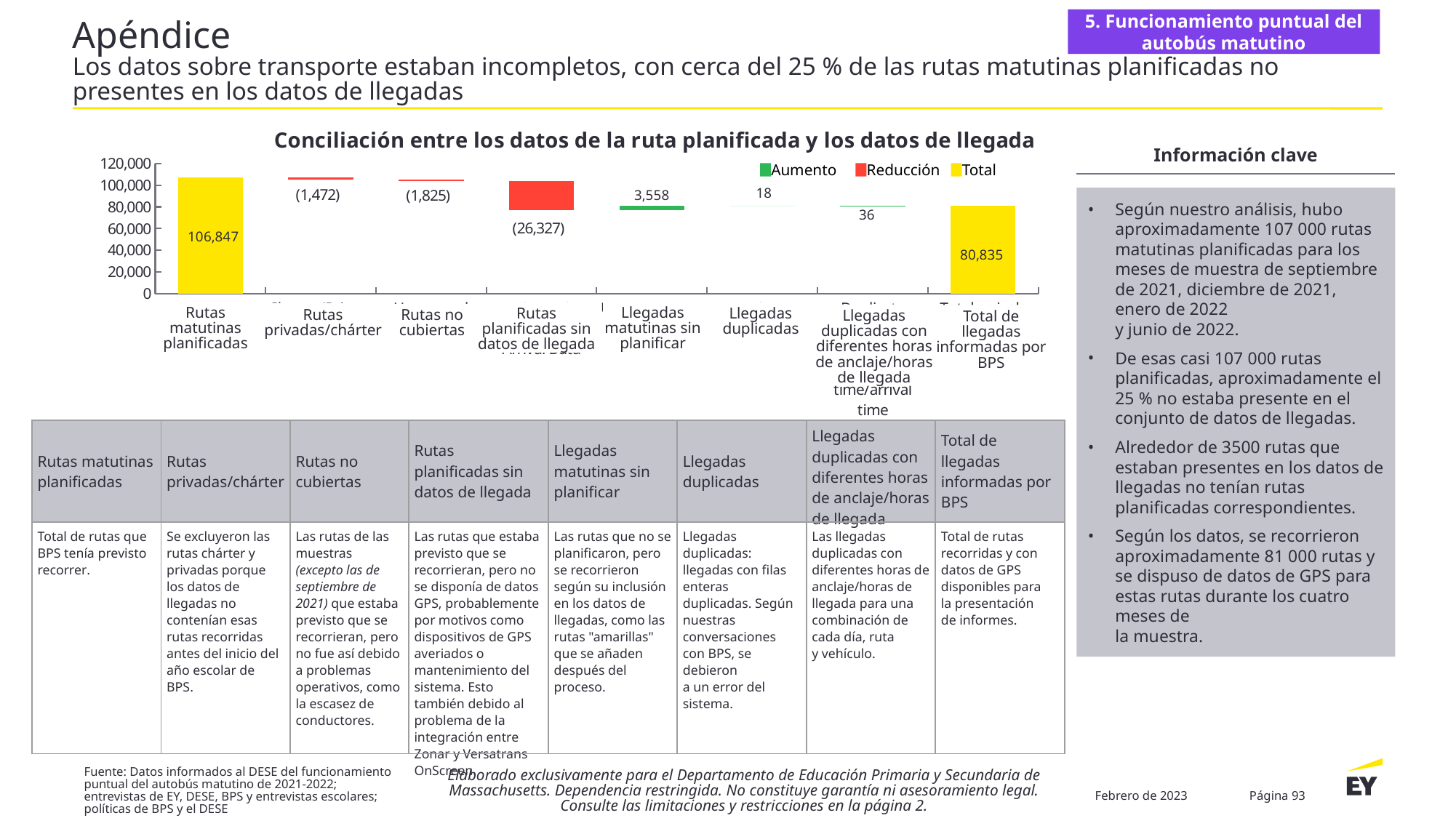
Which colour represents 'Reducción' in the legend? Red What value is shown for 'Rutas no cubiertas'? (1,825) How many categories are shown on the x axis? 8 What value is shown for 'Rutas planificadas sin datos de llegada'? (26,327) What value is shown for 'Rutas matutinas planificadas'? 106,847 What is the title of the chart? Conciliación entre los datos de la ruta planificada y los datos de llegada What value is shown for 'Rutas privadas/chárter'? (1,472) What value is shown for 'Total de llegadas informadas por BPS'? 80,835 What is the difference between 'Rutas matutinas planificadas' and 'Total de llegadas informadas por BPS'? 26,012 Which category has the highest value? Rutas matutinas planificadas What value is shown for 'Llegadas matutinas sin planificar'? 3,558 How many series does the legend list? 3